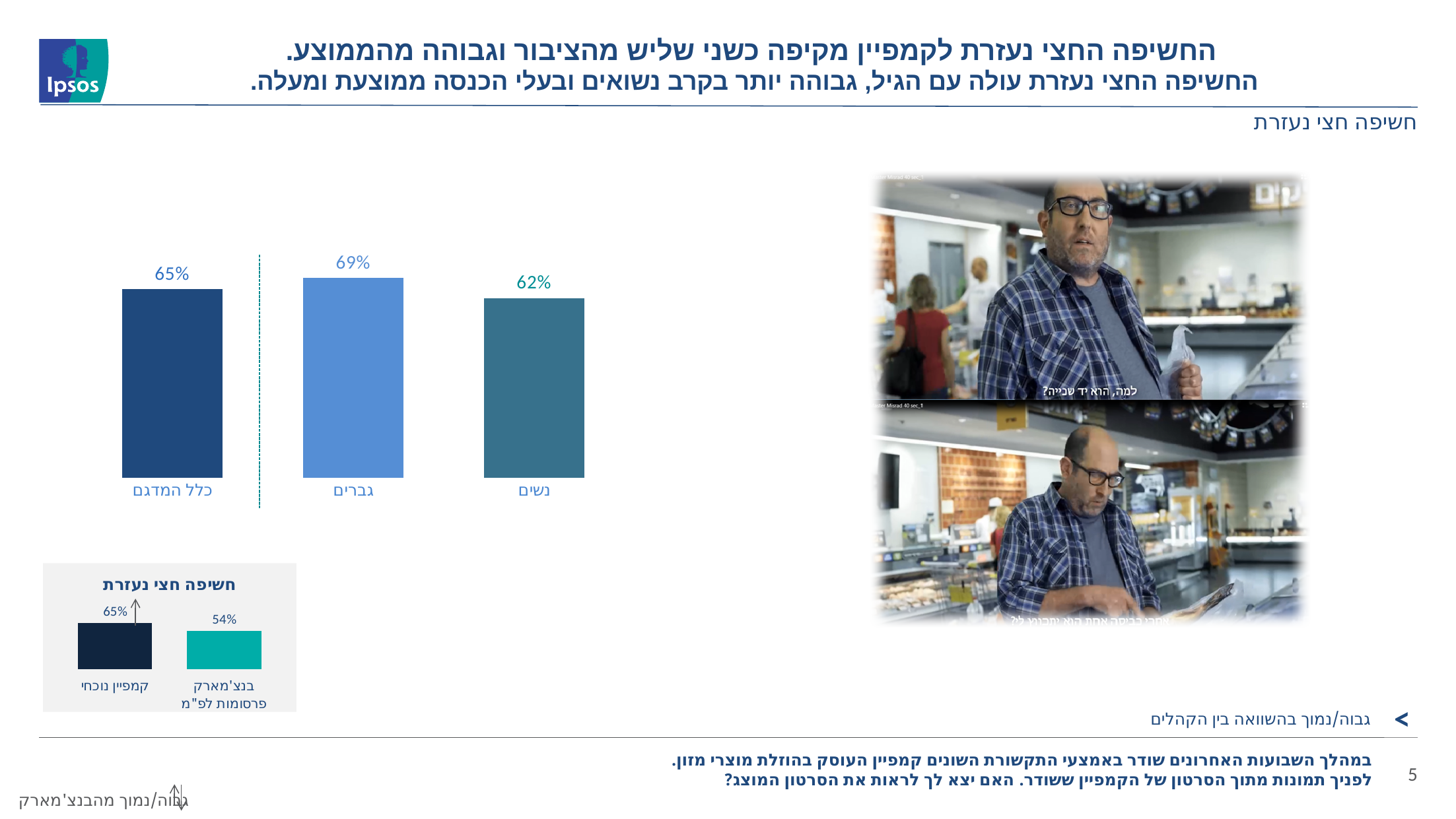
In the small chart titled חשיפה חצי נעזרת at the bottom left, what is the difference between קמפיין נוכחי and בנצ'מארק פרסומות לפ"מ? 11% In the main bar chart on the left, which category has the highest value? גברים In the main bar chart on the left, what is the value for כלל המדגם? 65% In the main bar chart on the left, what is the value for נשים? 62% In the main bar chart on the left, which is larger, the value for גברים or the value for כלל המדגם? גברים In the small chart titled חשיפה חצי נעזרת at the bottom left, what is the value for קמפיין נוכחי? 65% In the small chart titled חשיפה חצי נעזרת at the bottom left, what is the value for בנצ'מארק פרסומות לפ"מ? 54% What kind of chart is the main chart on the left? bar chart In the main bar chart on the left, which category has the lowest value? נשים In the main bar chart on the left, what is the value for גברים? 69% In the main bar chart on the left, what is the difference between the values for גברים and נשים? 7% How many bars are in the main bar chart on the left? 3